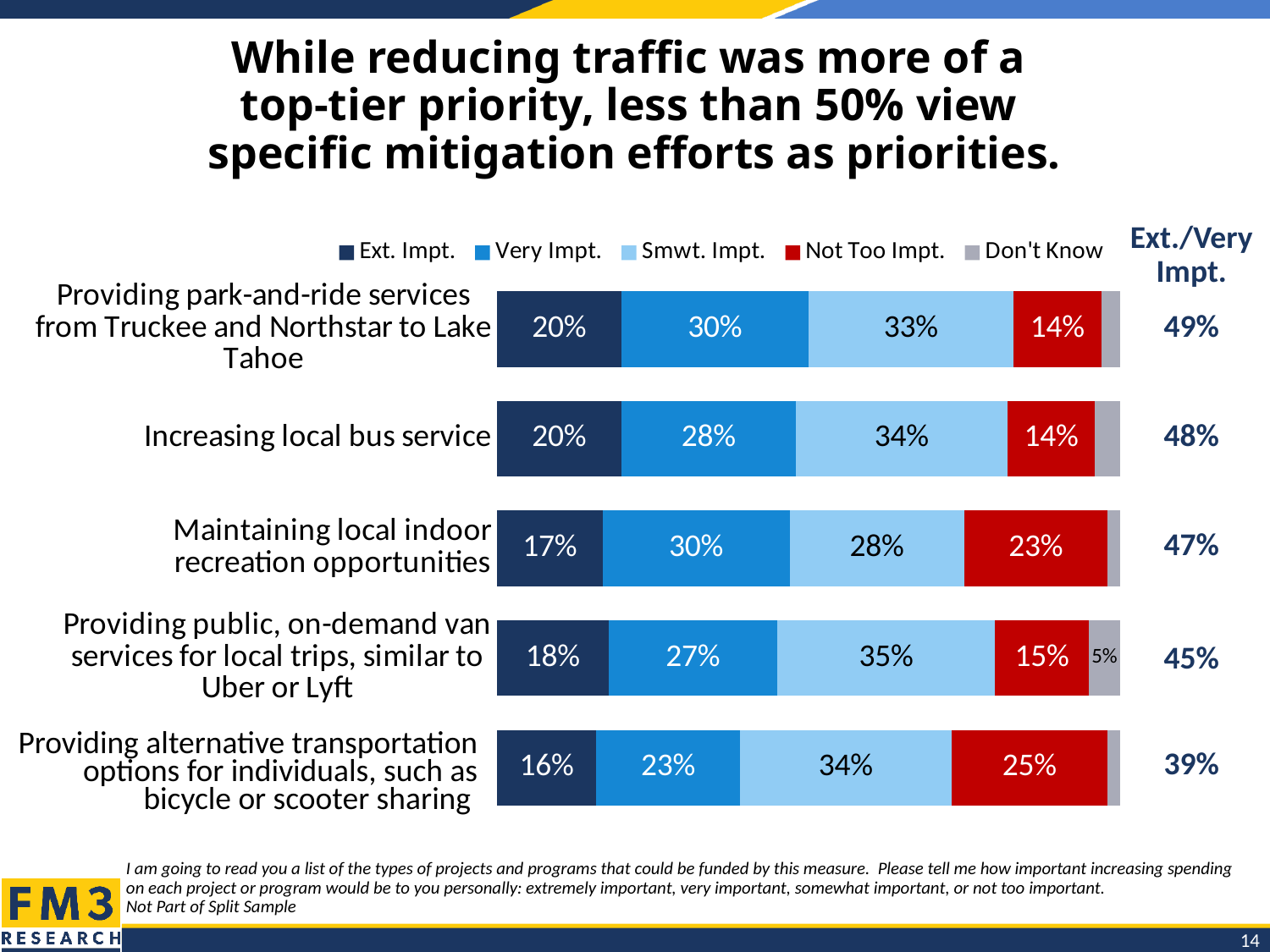
What is the Not Too Important value for 'Maintaining local indoor recreation opportunities'? 23% Which item has the lowest Ext./Very Impt. figure? Providing alternative transportation options for individuals, such as bicycle or scooter sharing What is the combined Ext./Very Impt. figure shown for 'Providing park-and-ride services from Truckee and Northstar to Lake Tahoe'? 49% What is the difference between the Ext./Very Impt. figures for 'Providing park-and-ride services from Truckee and Northstar to Lake Tahoe' and 'Providing alternative transportation options for individuals, such as bicycle or scooter sharing'? 10 percentage points Which has a larger Very Important value: 'Increasing local bus service' or 'Maintaining local indoor recreation opportunities'? Maintaining local indoor recreation opportunities What is the Somewhat Important value for 'Providing public, on-demand van services for local trips, similar to Uber or Lyft'? 35% What percentage rated 'Increasing local bus service' as Extremely Important? 20% What kind of chart is shown on the slide? Stacked bar chart What is the Don't Know value for 'Providing public, on-demand van services for local trips, similar to Uber or Lyft'? 5% How many items (categories) are shown in the chart? 5 How many series does the legend list? 5 Which item has the highest Not Too Important value? Providing alternative transportation options for individuals, such as bicycle or scooter sharing